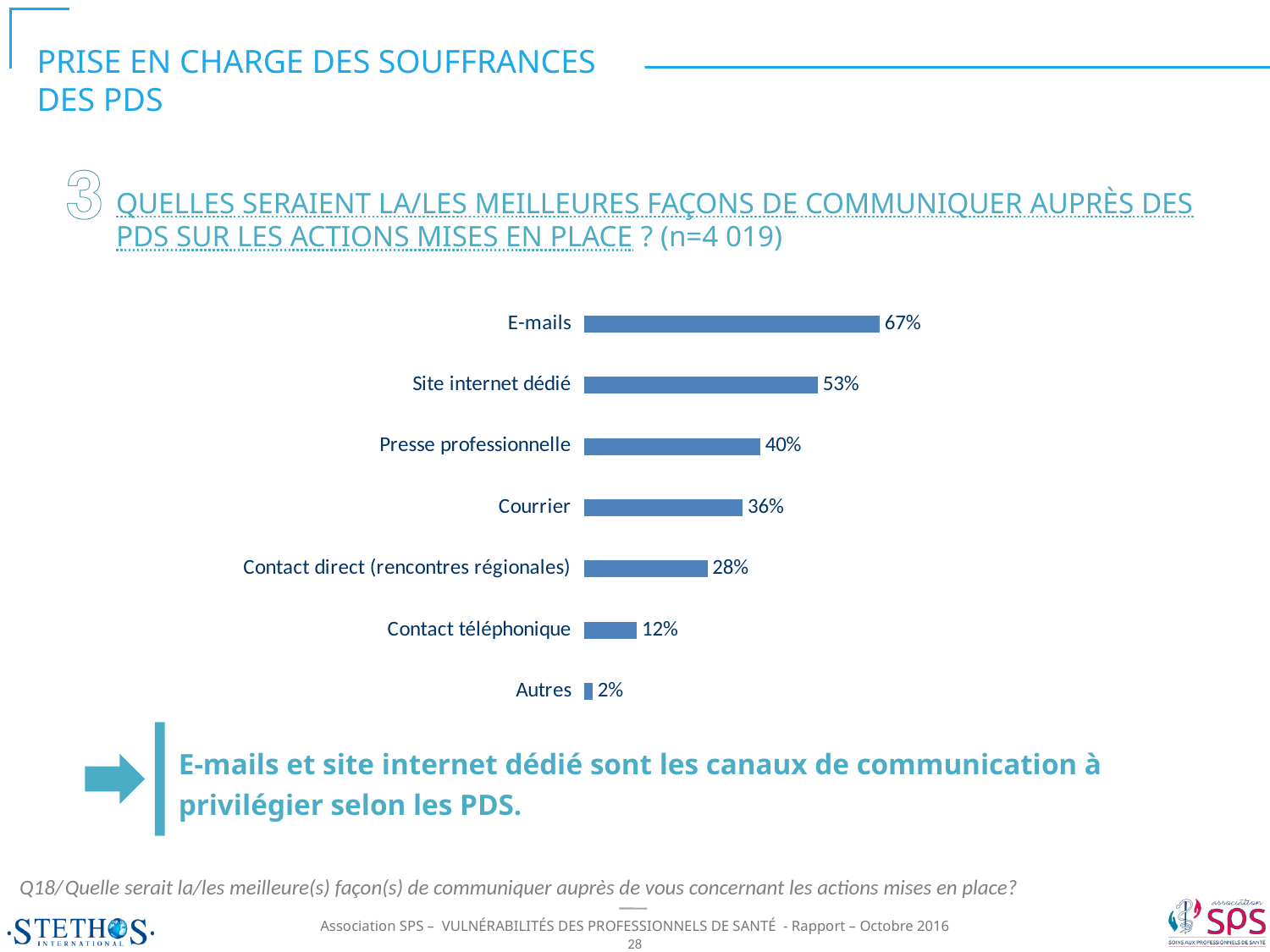
What kind of chart is shown on the slide? Bar chart What is the value for Contact direct (rencontres régionales)? 28% What is the value for E-mails? 67% What is the sample size (n) stated in the question above the chart? 4 019 Which category has the lowest value? Autres How many categories are shown in the chart? 7 Which is larger, the value for Courrier or the value for Contact direct (rencontres régionales)? Courrier What is the value for Contact téléphonique? 12% Which category has the highest value? E-mails What is the difference between the values for Presse professionnelle and Courrier? 4% What is the value for Site internet dédié? 53% What is the difference between the values for E-mails and Site internet dédié? 14%